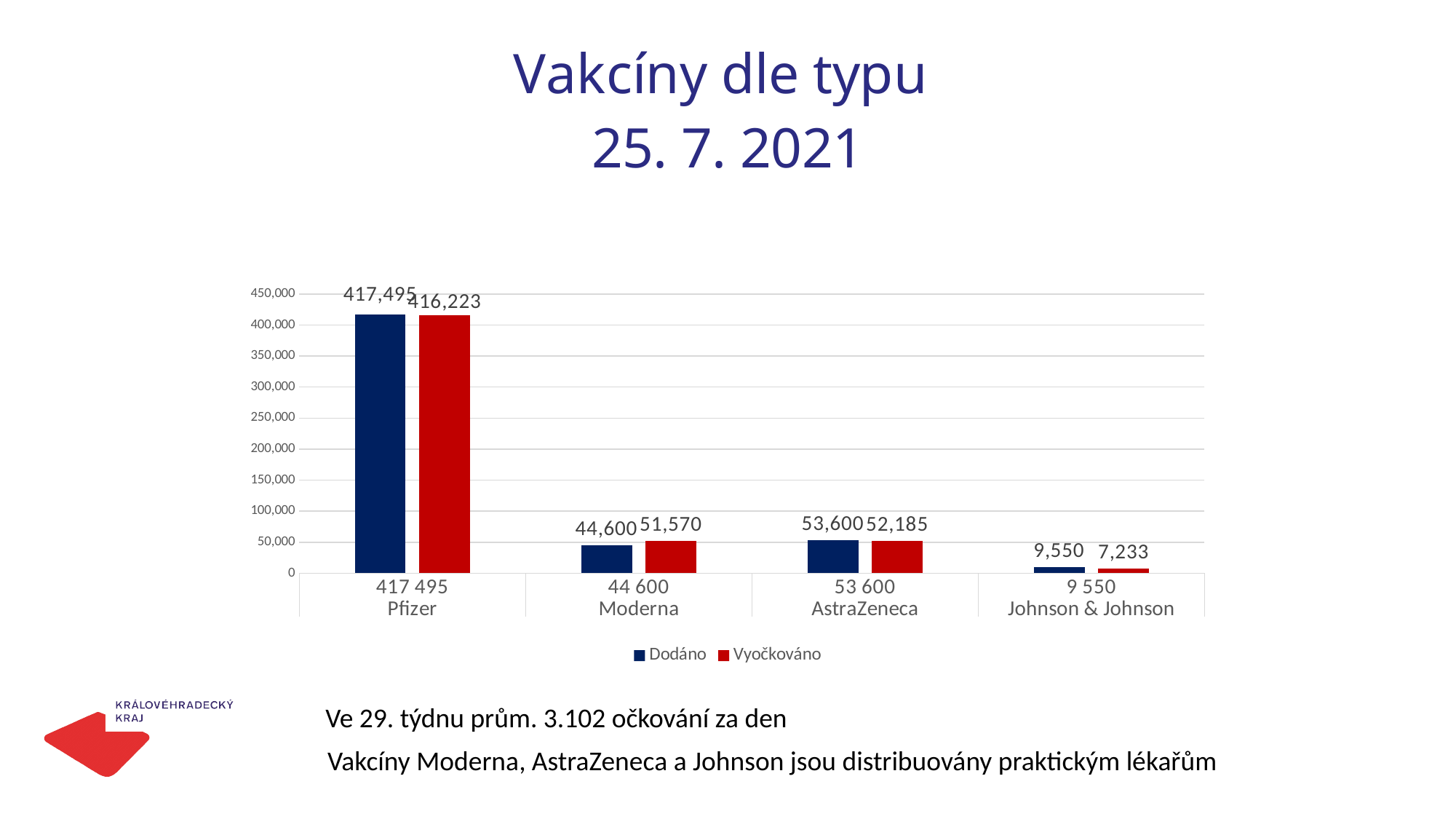
Which vaccine has the lowest Vyočkováno value? Johnson & Johnson Which vaccine has the highest Dodáno value? Pfizer How many vaccine types are shown on the x axis? 4 What is the Vyočkováno value for Moderna? 51,570 What is the Vyočkováno value for Johnson & Johnson? 7,233 How many series does the legend list? 2 What is the Dodáno value for Pfizer? 417,495 What is the difference between the Vyočkováno and Dodáno values for Moderna? 6,970 For AstraZeneca, which is larger: Dodáno or Vyočkováno? Dodáno What is the Dodáno value for AstraZeneca? 53,600 What is the difference between the Dodáno and Vyočkováno values for Pfizer? 1,272 What kind of chart is shown on the slide? Bar chart